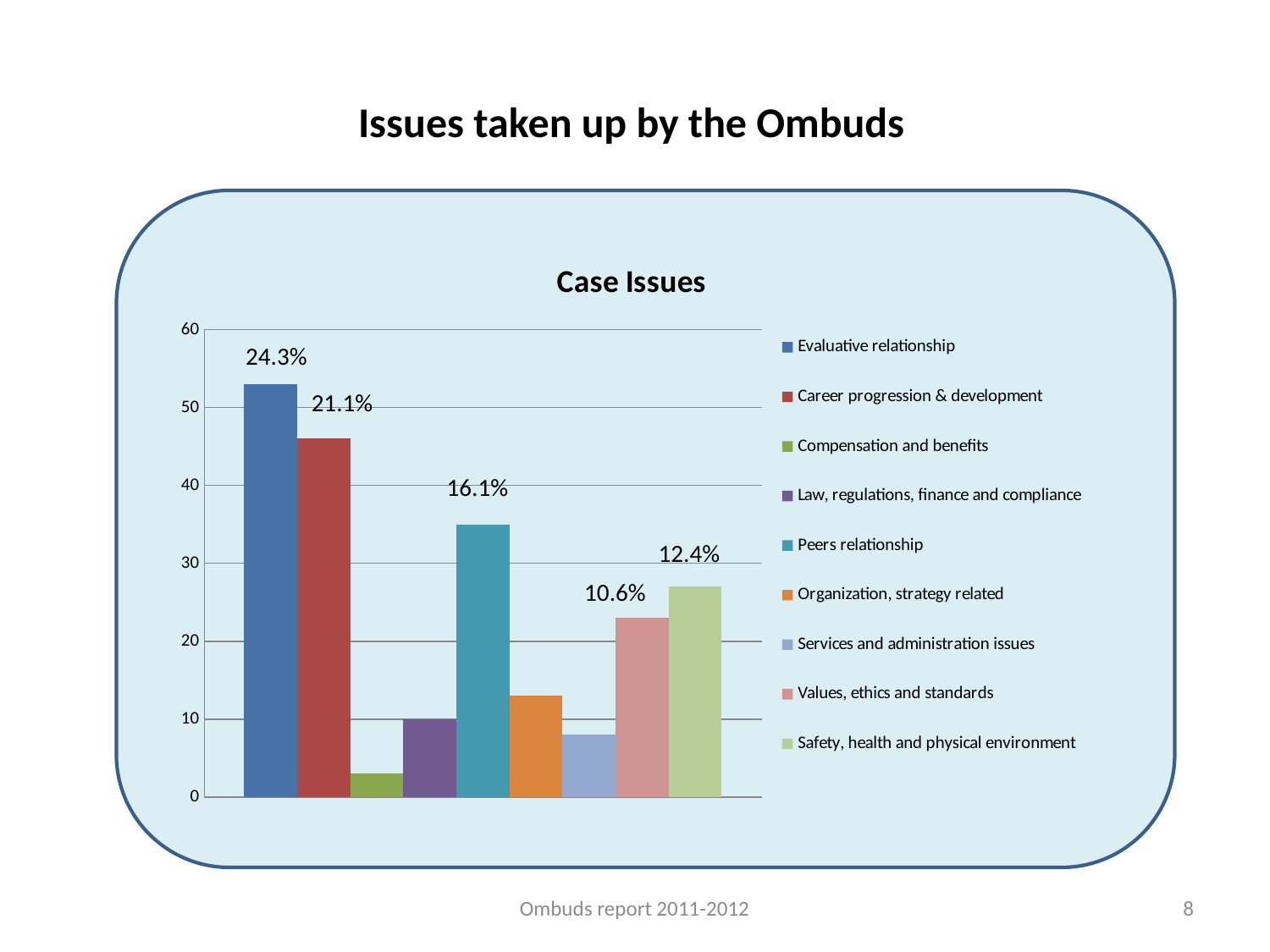
What type of chart is shown under the title "Case Issues"? bar chart What percentage label is shown above the Safety, health and physical environment bar? 12.4% How many series does the legend of the "Case Issues" chart list? 9 Which bar is taller: Values, ethics and standards or Organization, strategy related? Values, ethics and standards Is the value for Services and administration issues greater or less than 10? less Which series has the shortest bar in the "Case Issues" chart? Compensation and benefits Which series has the tallest bar in the "Case Issues" chart? Evaluative relationship What percentage label is shown above the Career progression & development bar? 21.1% What is the title of the chart inside the rounded box? Case Issues What percentage label is shown above the Evaluative relationship bar? 24.3% Is the value for Career progression & development greater or less than 40? greater What percentage label is shown above the Peers relationship bar? 16.1%